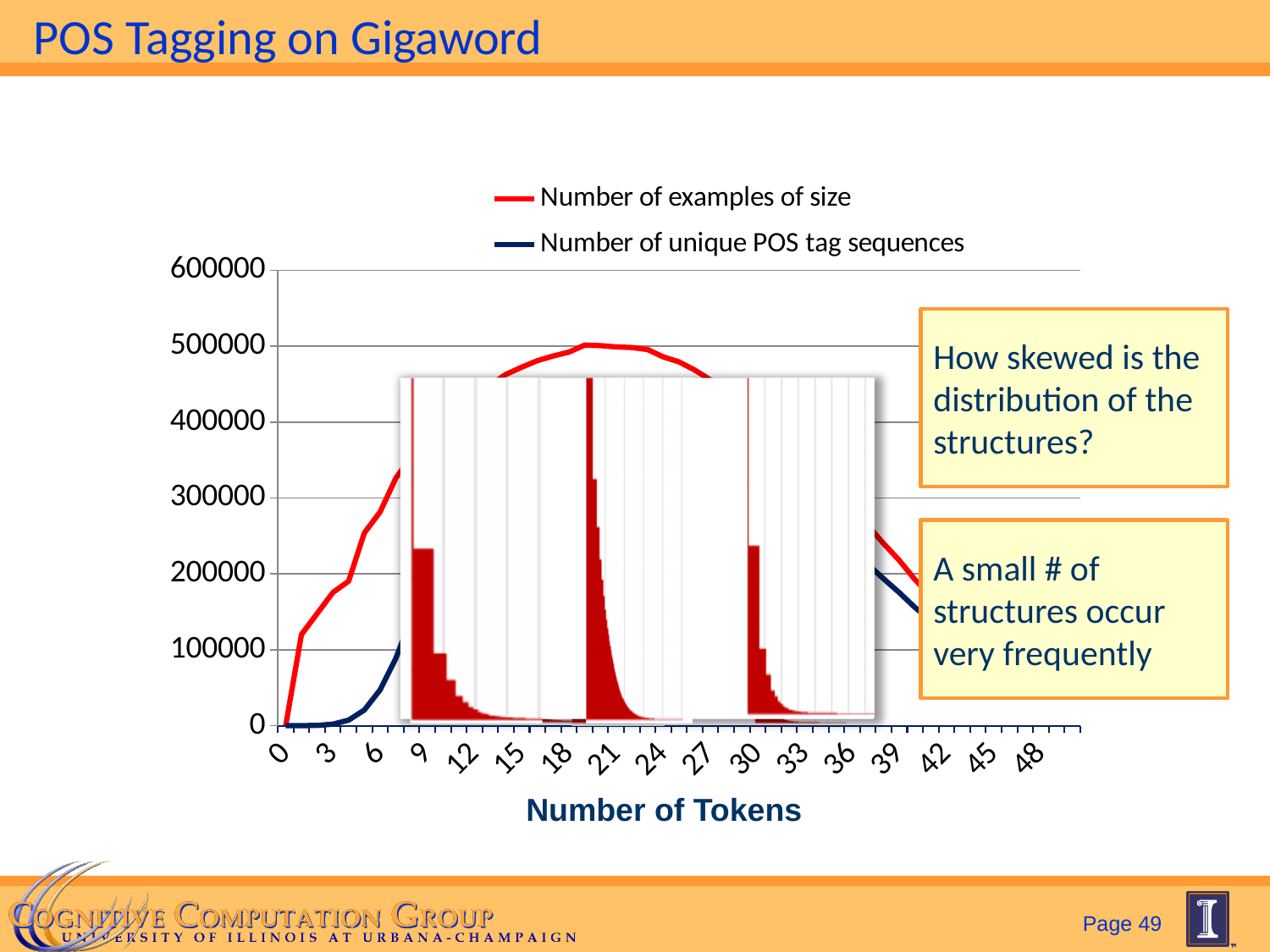
Is the value of 'Number of examples of size' at 3 tokens greater or less than 100000? greater Is the value of 'Number of unique POS tag sequences' at 3 tokens greater or less than 100000? less What is the title of the x axis? Number of Tokens Is the value of 'Number of examples of size' at 6 tokens greater or less than 200000? greater At 3 tokens, which series has the larger value: 'Number of examples of size' or 'Number of unique POS tag sequences'? Number of examples of size Which series reaches the higher maximum value on the chart? Number of examples of size What are the two series named in the legend? Number of examples of size; Number of unique POS tag sequences Between 0 and 6 tokens, does the 'Number of examples of size' series rise or fall? rise What kind of chart is shown on the slide? line chart Between 39 and 48 tokens, does the 'Number of unique POS tag sequences' series rise or fall? fall How many series does the chart's legend list? 2